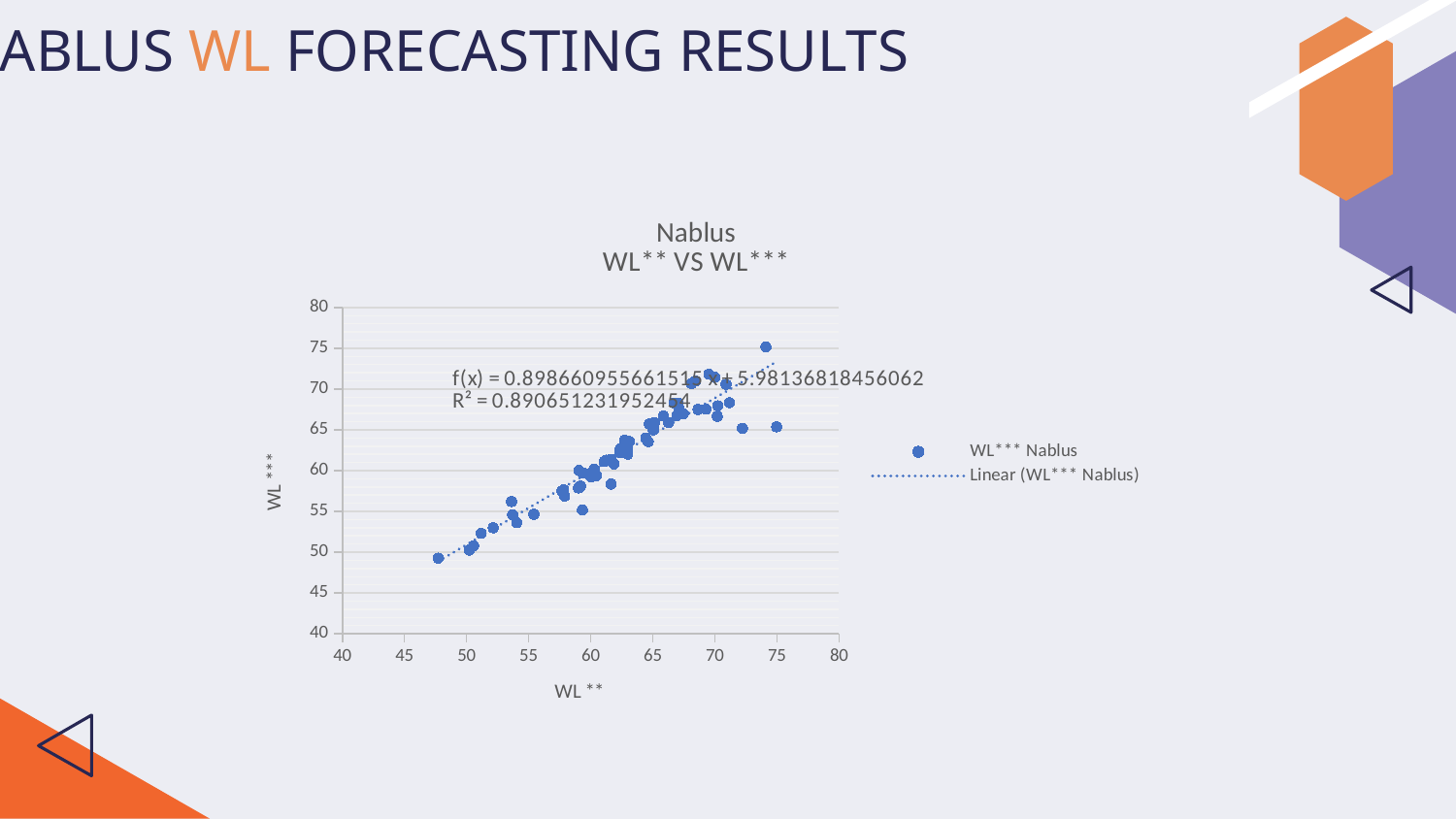
What R² value is printed on the chart? R² = 0.890651231952454 What is the maximum value shown on the y axis? 80 Is the WL*** value of the highest plotted point greater or less than 70? greater How many entries does the chart legend list? 2 What is the slope of the linear trendline equation printed on the chart? 0.898660955661515 Do the WL*** values generally rise or fall as WL** increases along the x axis? Rise What is the title of the chart? Nablus WL** VS WL*** What is the label of the x axis? WL ** Is the WL*** value of the leftmost plotted point greater or less than 55? less What kind of chart is shown on the slide? Scatter chart Is the WL** value of the rightmost plotted point greater or less than 70? greater What is the intercept of the linear trendline equation printed on the chart? 5.98136818456062